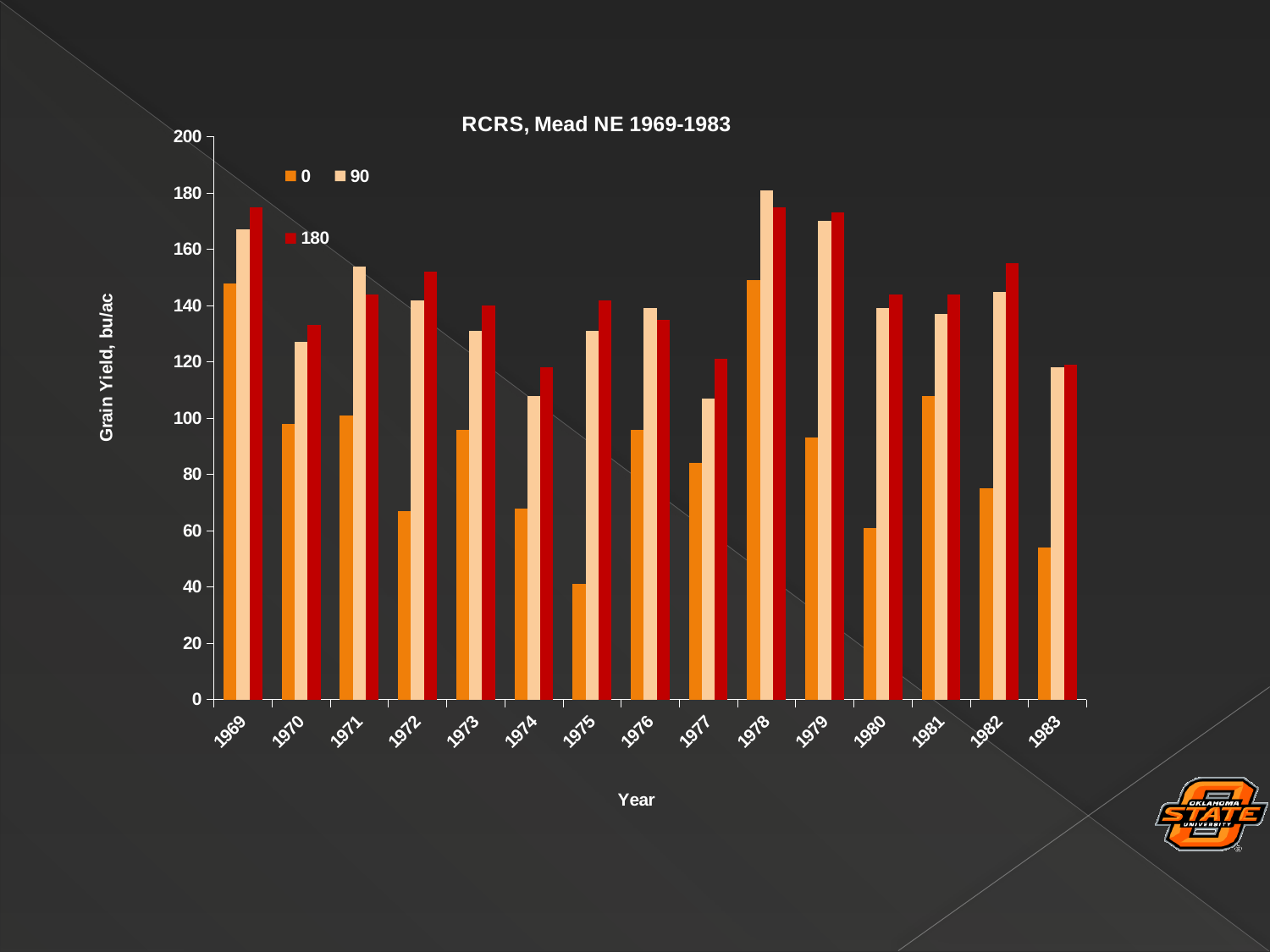
What is the title of the chart? RCRS, Mead NE 1969-1983 Is the value for the 90 series in 1978 greater or less than 160? greater What is the label on the vertical axis? Grain Yield, bu/ac Is the value for the 0 series in 1975 greater or less than 60? less What kind of chart is shown on the slide? bar chart In which year is the value for the 90 series highest? 1978 In which year is the value for the 0 series lowest? 1975 Is the value for the 180 series in 1969 greater or less than 160? greater Which year has the larger value for the 0 series, 1972 or 1973? 1973 How many series does the legend list? 3 How many years are shown along the x axis? 15 Which year has the larger value for the 90 series, 1977 or 1979? 1979